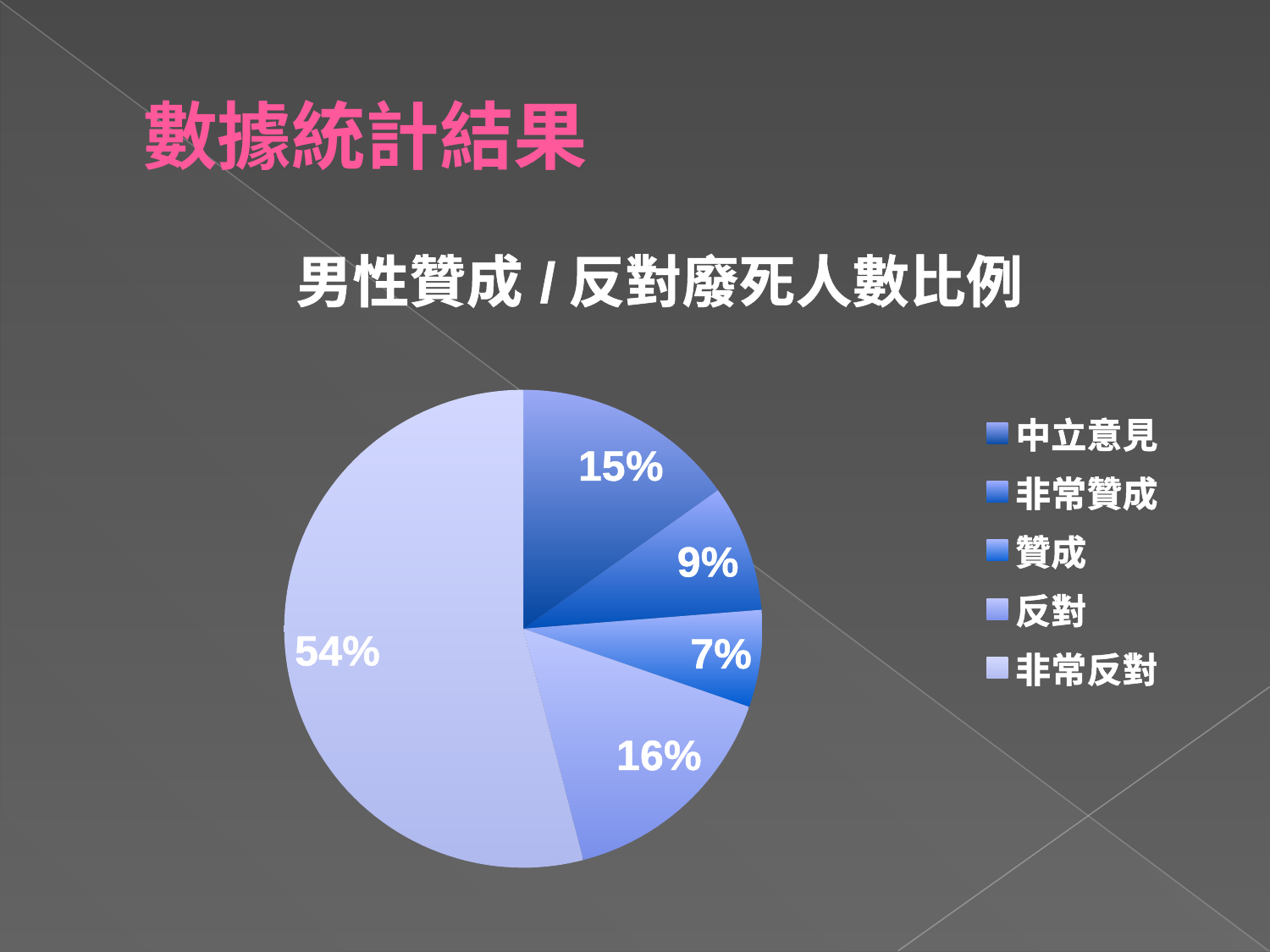
Which is larger, the share for 中立意見 or the share for 非常贊成? 中立意見 What percentage of the pie is 贊成? 7% What percentage of the pie is 中立意見? 15% What percentage of the pie is 非常反對? 54% Which category has the smallest share of the pie? 贊成 How many categories does the legend list? 5 What is the difference in percentage points between 非常反對 and 反對? 38 What is the title of the chart? 男性贊成 / 反對廢死人數比例 What type of chart is shown on the slide? pie chart What percentage of the pie is 非常贊成? 9% What percentage of the pie is 反對? 16% Which category has the largest share of the pie? 非常反對